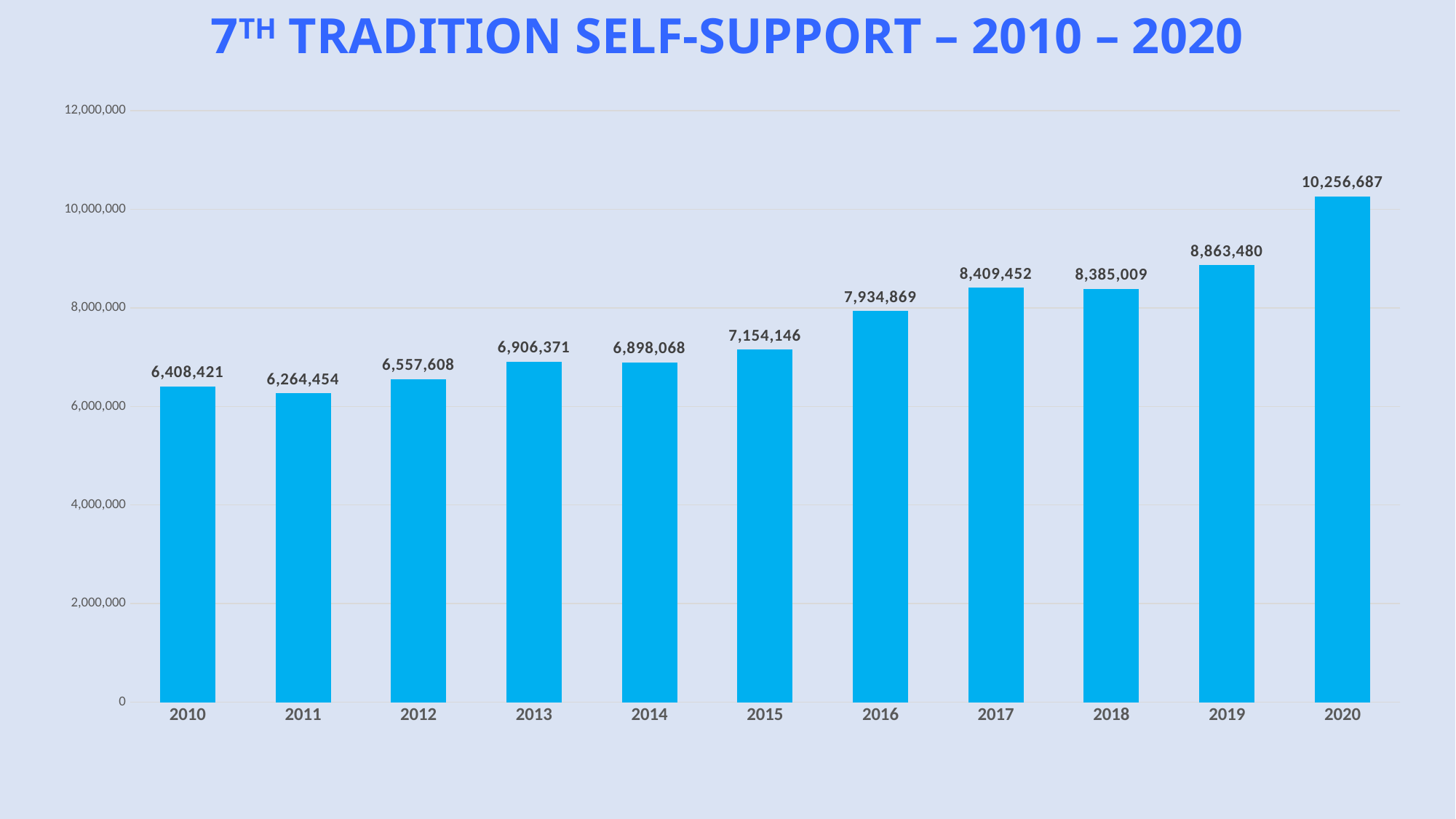
How many years are shown on the x axis? 11 Which year has the highest value? 2020 What is the value for 2014? 6,898,068 Which is larger, the value for 2016 or the value for 2015? 2016 What is the difference between the values for 2010 and 2011? 143,967 What is the difference between the values for 2020 and 2019? 1,393,207 Is the value for 2018 greater or less than 8,000,000? greater What kind of chart is shown on the slide? bar chart What is the value for 2011? 6,264,454 What is the value for 2020? 10,256,687 Which year has the lowest value? 2011 What is the title of the chart? 7TH TRADITION SELF-SUPPORT – 2010 – 2020